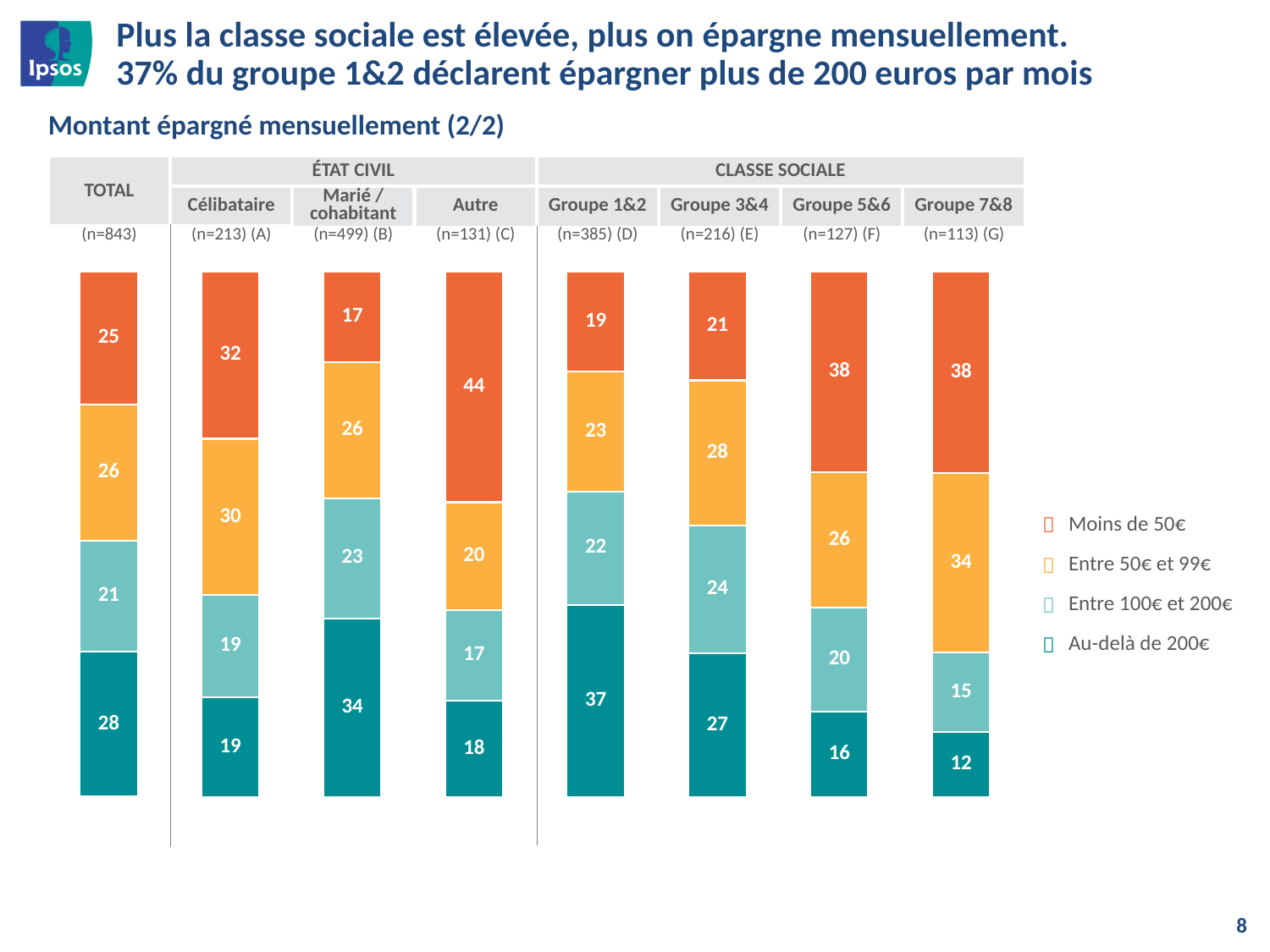
Which category has the highest value for 'Au-delà de 200€'? Groupe 1&2 What is the value for 'Au-delà de 200€' in the Groupe 1&2 bar? 37 What is the total of the four segments in the TOTAL bar? 100 What is the difference between the 'Moins de 50€' values for Célibataire and Marié / cohabitant? 15 Which has the larger 'Entre 50€ et 99€' value, Groupe 5&6 or Groupe 7&8? Groupe 7&8 How many bars (categories) are shown in the chart? 8 How many series does the legend list? 4 What is the value for 'Moins de 50€' in the Autre bar? 44 What kind of chart is shown on the slide? Stacked bar chart What is the sample size shown for the Marié / cohabitant category? n=499 What is the value for 'Entre 100€ et 200€' in the Groupe 3&4 bar? 24 Which category has the lowest value for 'Au-delà de 200€'? Groupe 7&8